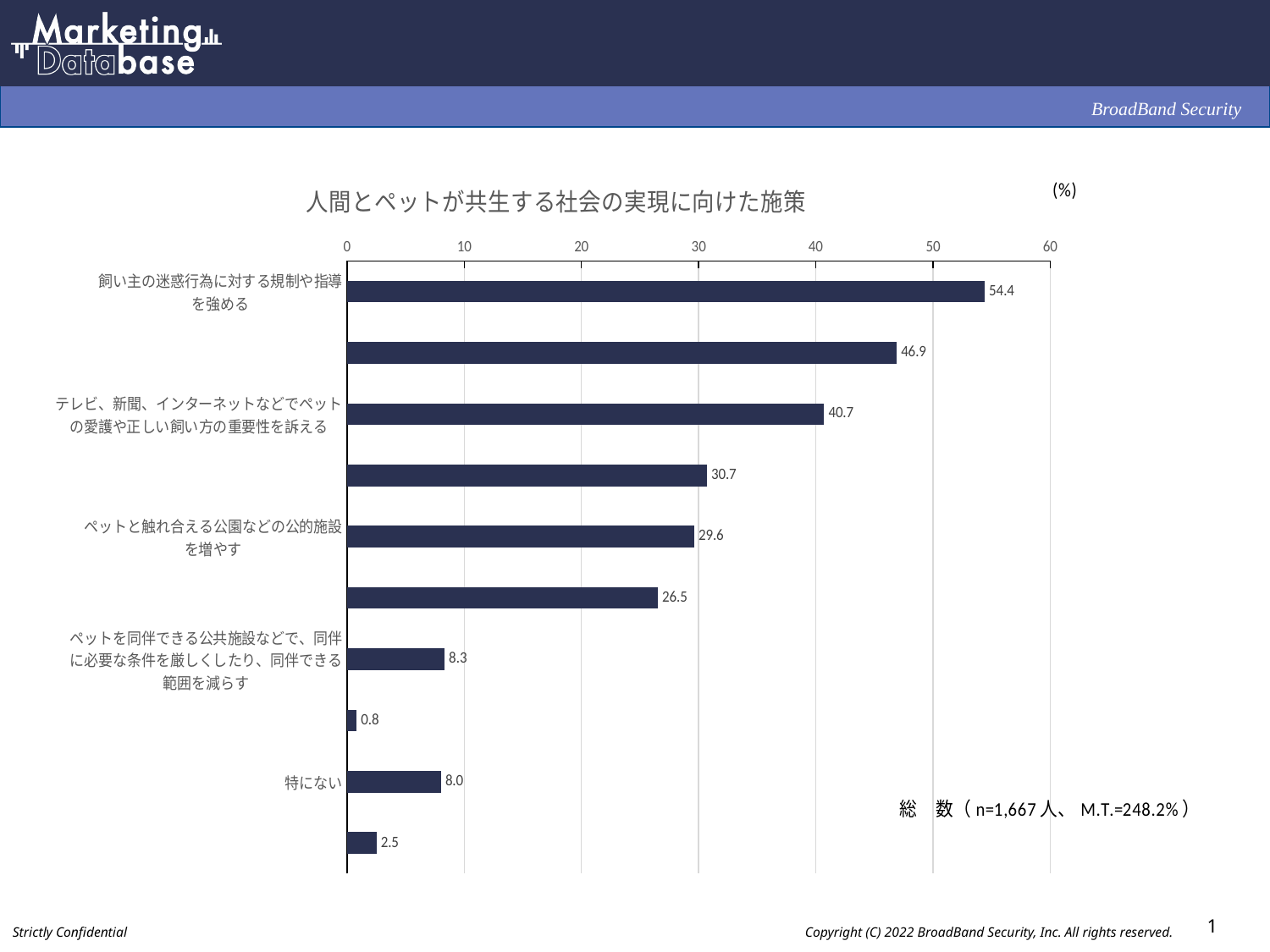
What is the value for ペットを同伴できる公共施設などで、同伴に必要な条件を厳しくしたり、同伴できる範囲を減らす? 8.3 Which is larger, the value for ペットと触れ合える公園などの公的施設を増やす or the value for 特にない? ペットと触れ合える公園などの公的施設を増やす What is the title of the chart? 人間とペットが共生する社会の実現に向けた施策 What is the value for テレビ、新聞、インターネットなどでペットの愛護や正しい飼い方の重要性を訴える? 40.7 What kind of chart is shown on the slide? Bar chart How many bars are plotted on the chart? 10 What is the value for 飼い主の迷惑行為に対する規制や指導を強める? 54.4 What is the value for 特にない? 8.0 Which labeled category has the highest value? 飼い主の迷惑行為に対する規制や指導を強める What is the value for ペットと触れ合える公園などの公的施設を増やす? 29.6 What is the smallest value shown on the chart? 0.8 What is the difference between the values for 飼い主の迷惑行為に対する規制や指導を強める and テレビ、新聞、インターネットなどでペットの愛護や正しい飼い方の重要性を訴える? 13.7